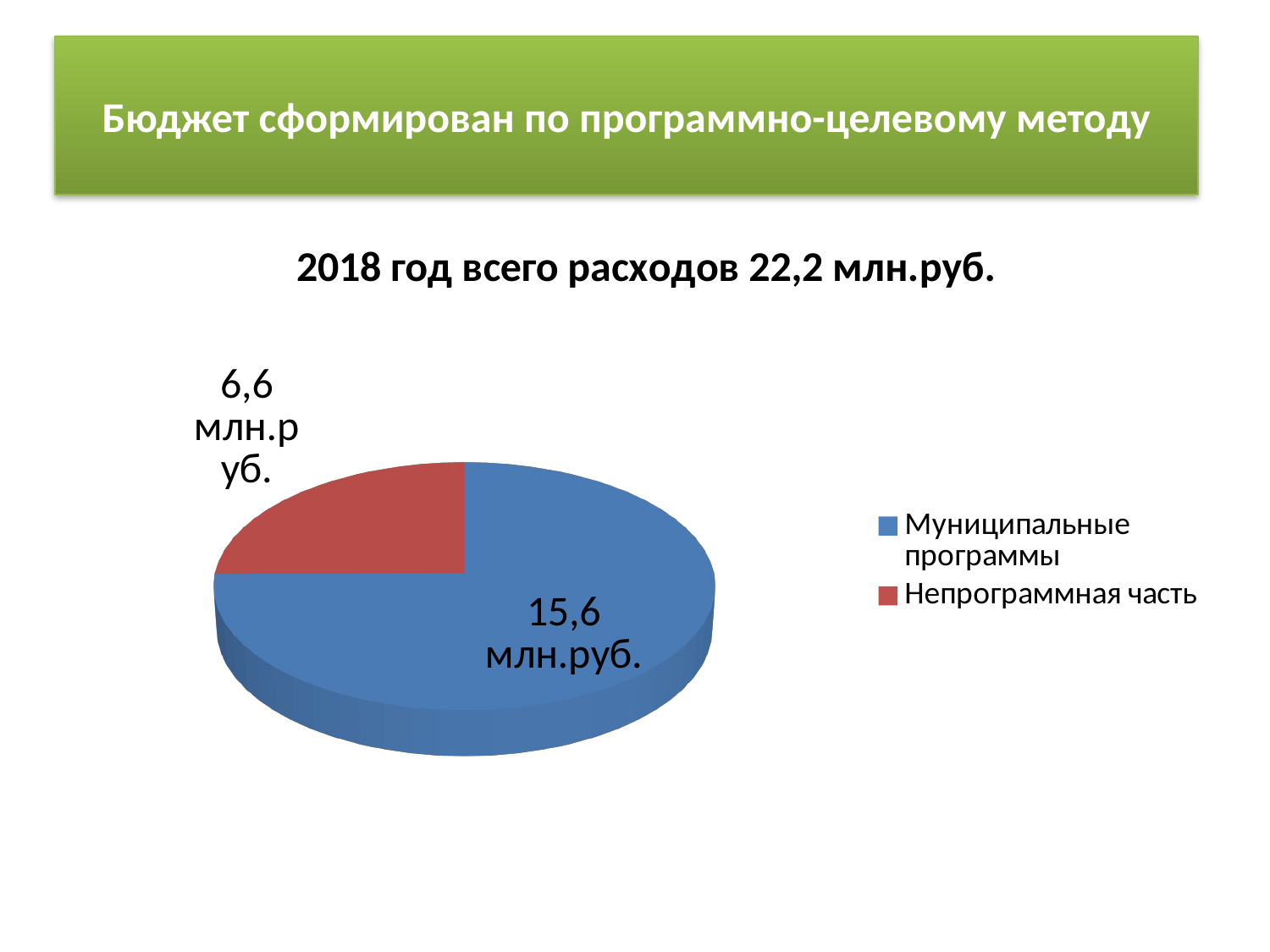
Which is larger: Муниципальные программы or Непрограммная часть? Муниципальные программы What is the title of the slide? Бюджет сформирован по программно-целевому методу Which category has the smallest slice of the pie? Непрограммная часть How many slices does the pie chart have? 2 Which category has the largest slice of the pie? Муниципальные программы What colour is the slice for Непрограммная часть? red What is the value for Непрограммная часть? 6,6 млн.руб. What kind of chart is shown on the slide? pie chart How many entries does the legend list? 2 What is the difference between Муниципальные программы and Непрограммная часть? 9,0 млн.руб. What is the total of all expenditures for 2018 shown on the slide? 22,2 млн.руб. What is the value for Муниципальные программы? 15,6 млн.руб.